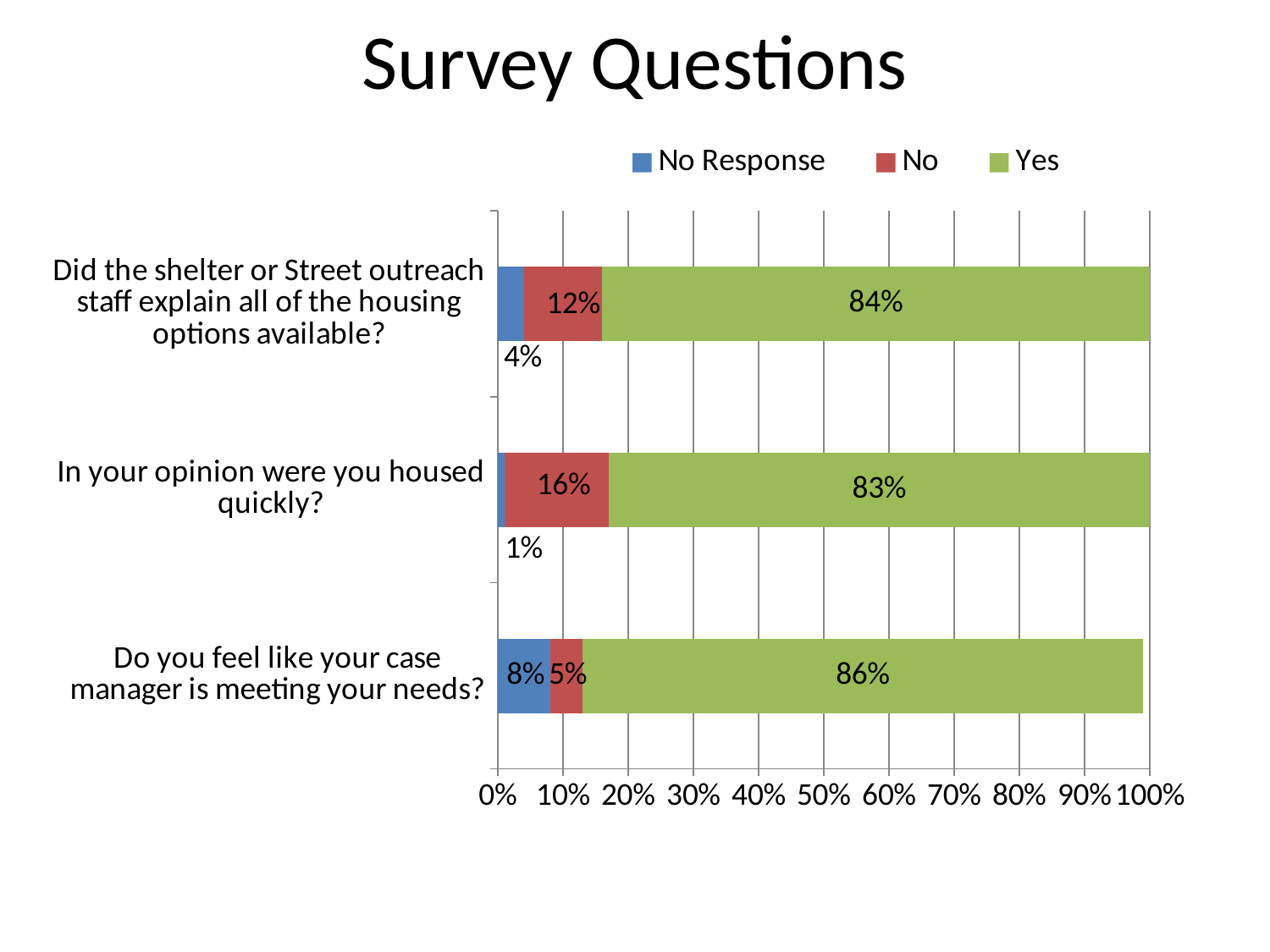
Which colour represents the Yes responses in the chart? Green What is the No Response value for "Did the shelter or Street outreach staff explain all of the housing options available?" 4% How many series does the legend list? 3 Which survey question has the highest Yes percentage? Do you feel like your case manager is meeting your needs? What percentage answered Yes to "Do you feel like your case manager is meeting your needs?" 86% Which is larger: the No Response value for "Do you feel like your case manager is meeting your needs?" or the No value for the same question? No Response How many survey questions are shown on the chart? 3 Which survey question has the lowest No percentage? Do you feel like your case manager is meeting your needs? What kind of chart is shown on the slide? Stacked bar chart What is the difference between the No percentages for "In your opinion were you housed quickly?" and "Did the shelter or Street outreach staff explain all of the housing options available?" 4% What is the No Response value for "In your opinion were you housed quickly?" 1% What percentage answered No to "In your opinion were you housed quickly?" 16%